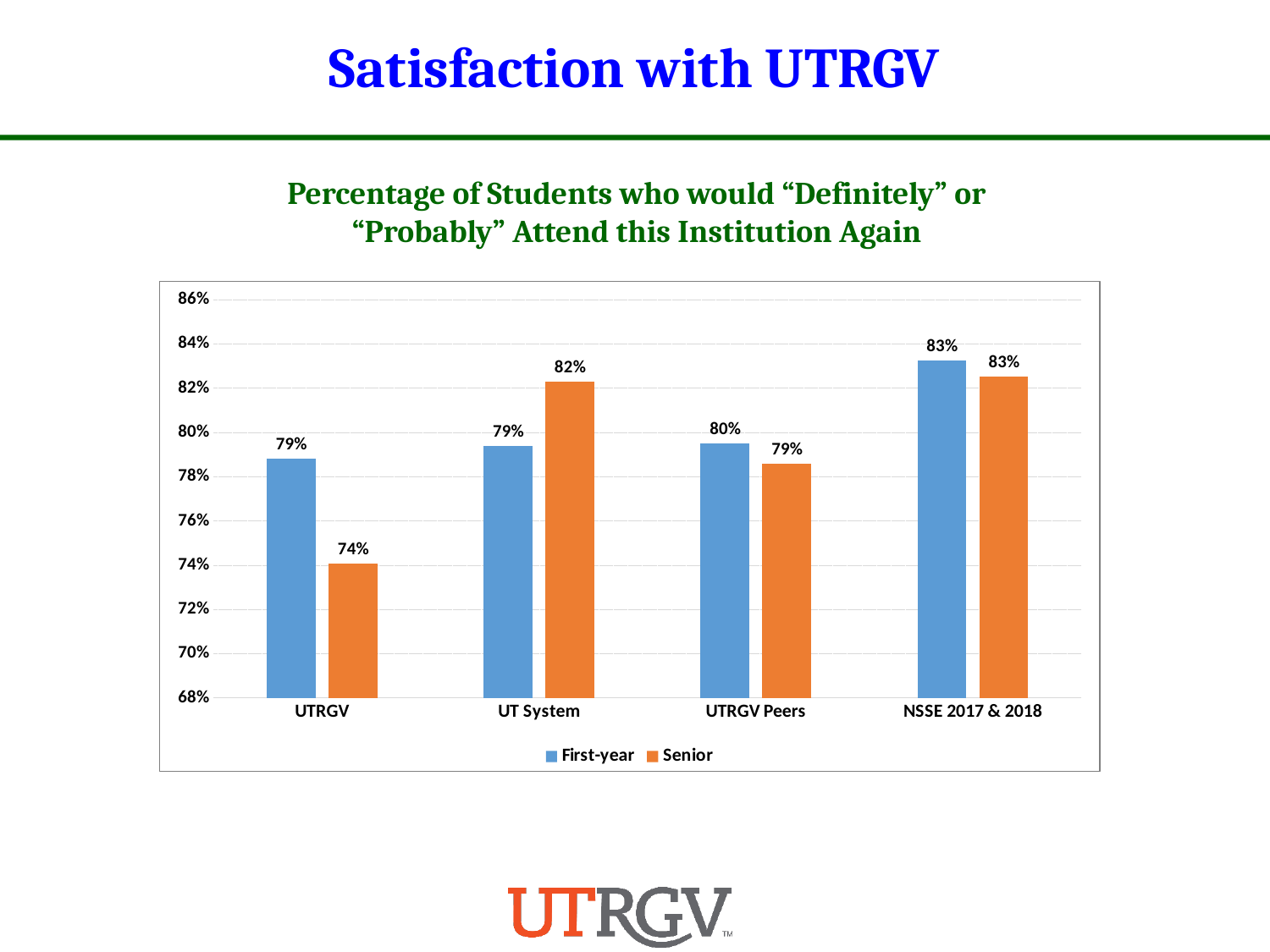
Which category has the highest First-year value? NSSE 2017 & 2018 What is the Senior value for UTRGV? 74% What kind of chart is shown on the slide? bar chart What is the difference between the First-year and Senior values for UTRGV? 5% Is the Senior value for UTRGV greater or less than 76%? less What is the Senior value for UT System? 82% For UT System, which is larger, the First-year value or the Senior value? Senior How many categories are shown on the x axis? 4 What is the First-year value for UTRGV? 79% Which category has the lowest Senior value? UTRGV What is the First-year value for UTRGV Peers? 80% How many series does the legend list? 2